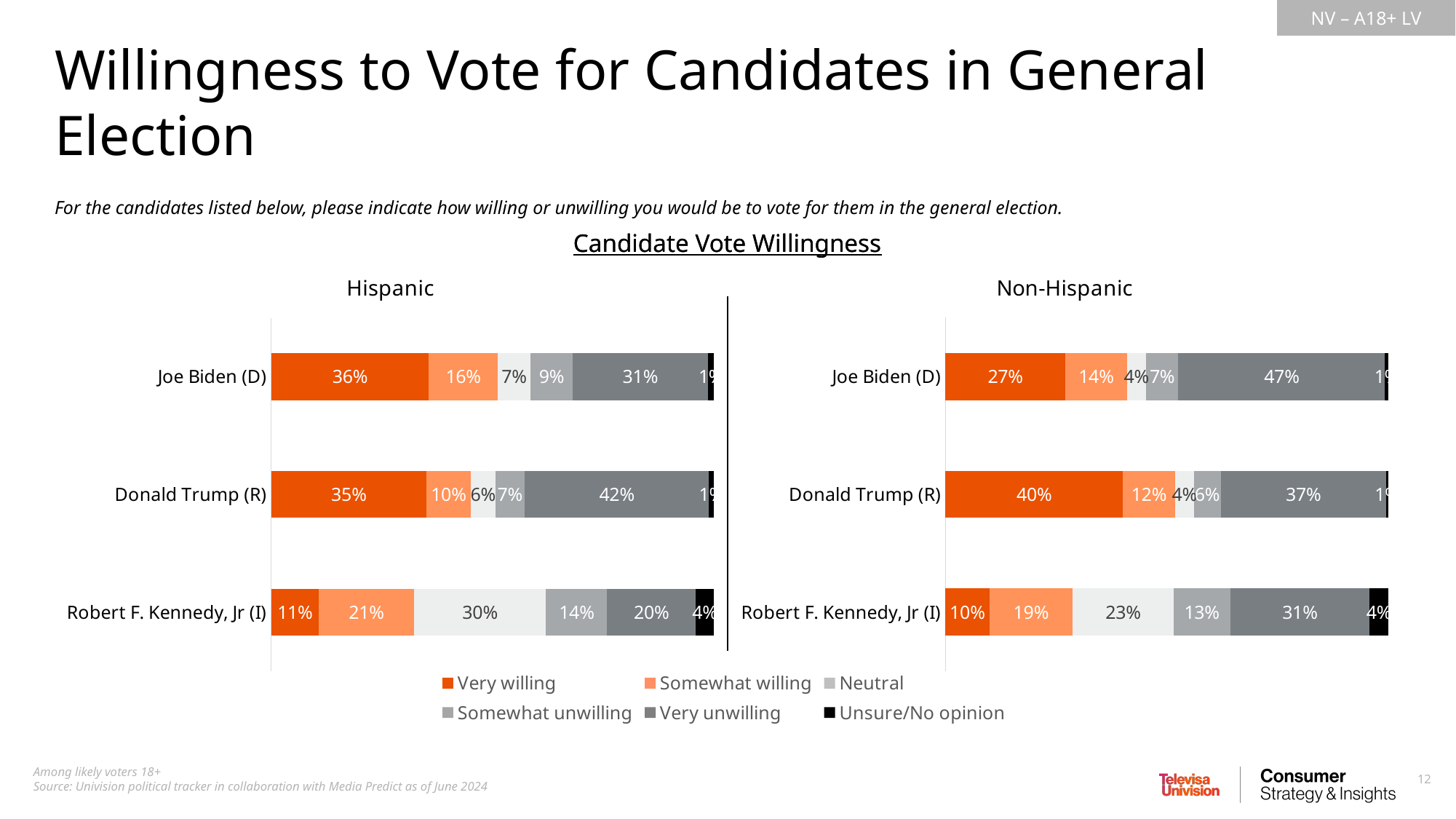
How many candidates are shown in the Hispanic chart? 3 In the Hispanic chart, what is the difference between the very unwilling percentages for Donald Trump (R) and Joe Biden (D)? 11% What type of chart is used to show Candidate Vote Willingness? Stacked bar chart In the Non-Hispanic chart, which candidate has the lowest very willing percentage? Robert F. Kennedy, Jr (I) How many series does the legend list for the charts? 6 In the Hispanic chart, which candidate has the highest very unwilling percentage? Donald Trump (R) In the Hispanic chart, what percentage of respondents are neutral on Robert F. Kennedy, Jr (I)? 30% In the Hispanic chart, what percentage of respondents are very willing to vote for Joe Biden (D)? 36% In the Non-Hispanic chart, what percentage of respondents are very unwilling to vote for Joe Biden (D)? 47% Is the very willing percentage for Joe Biden (D) higher in the Hispanic chart or the Non-Hispanic chart? Hispanic In the Non-Hispanic chart, what is the difference between the very willing percentages for Donald Trump (R) and Joe Biden (D)? 13% In the Non-Hispanic chart, what percentage of respondents are somewhat willing to vote for Donald Trump (R)? 12%